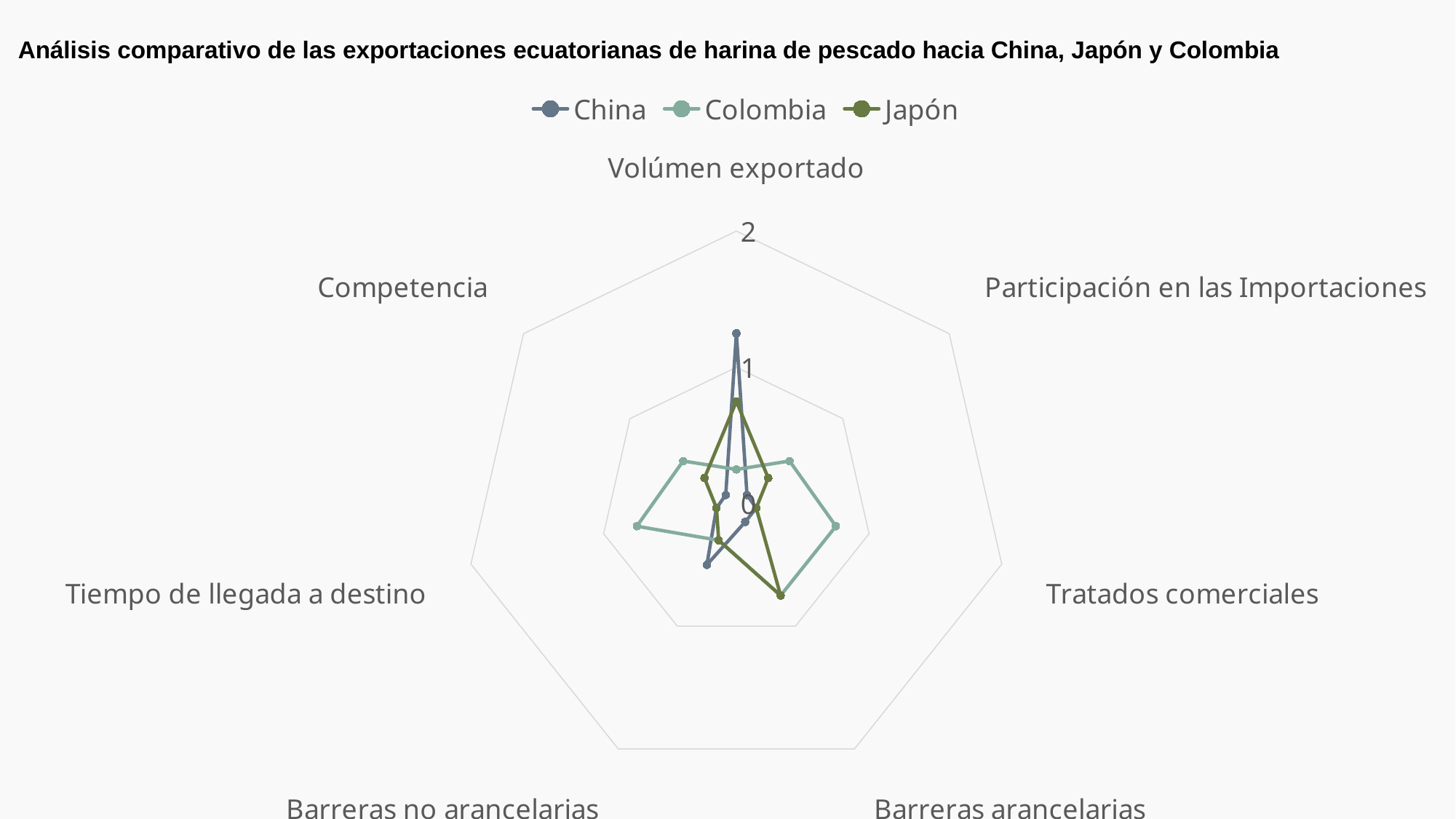
Which series has the highest value for Tratados comerciales? Colombia How many series does the legend list? 3 What kind of chart is shown on the slide? Radar chart Which series has the highest value for Tiempo de llegada a destino? Colombia Which series has the highest value for Volúmen exportado? China What are the three series named in the legend? China, Colombia, Japón Is Japón's value for Volúmen exportado greater or less than 1? less Is China's value for Volúmen exportado greater or less than 2? less How many categories (axes) does the radar chart have? 7 Is China's value for Volúmen exportado greater or less than 1? greater Which is larger for Volúmen exportado: China or Colombia? China